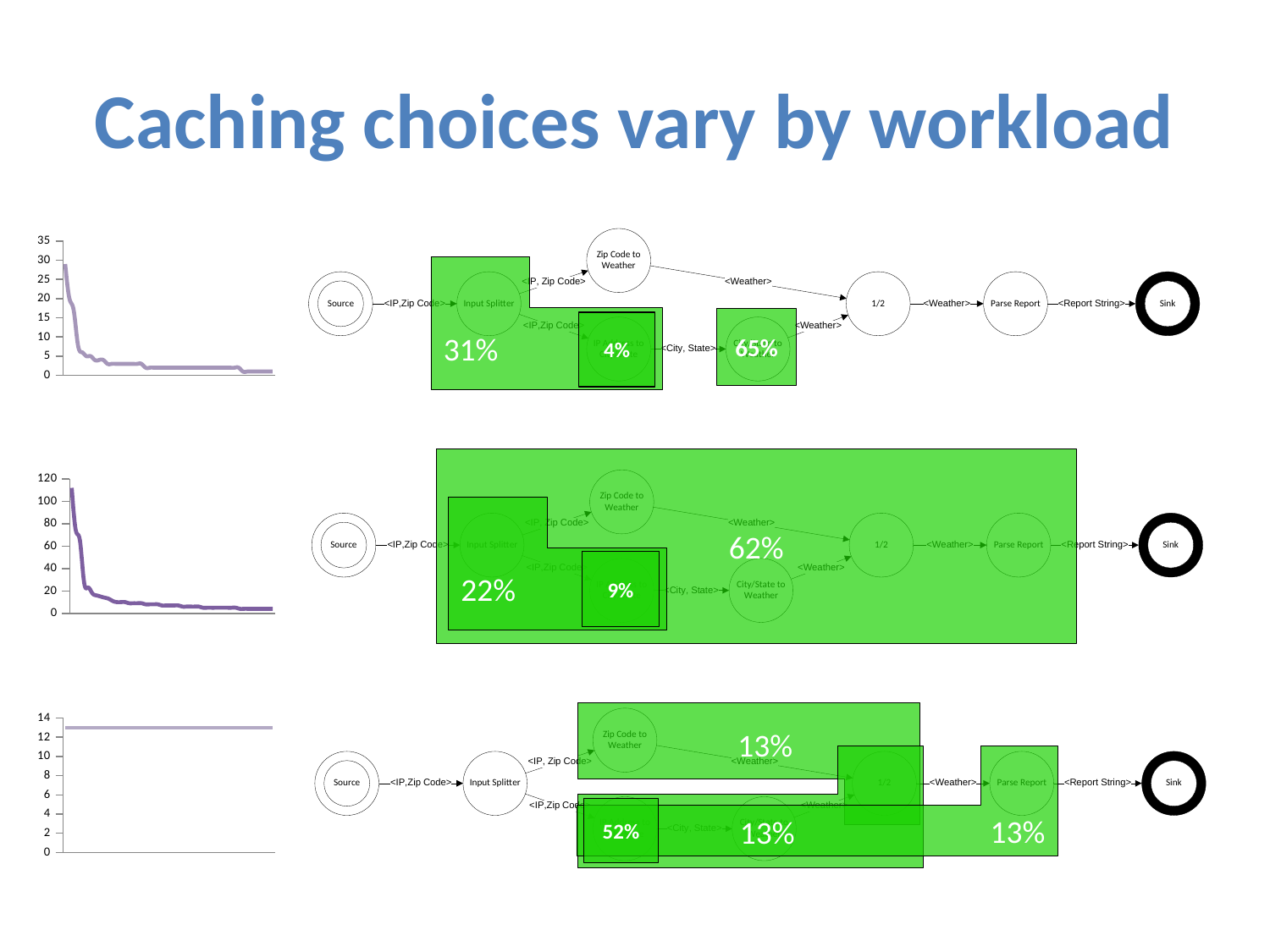
What kind of chart is the top-left chart on the slide? line chart In the bottom-left line chart, is the plotted value greater or less than 12? greater In the top-left line chart, do the values rise or fall along the x axis? fall In the middle-left line chart, is the first value greater or less than 100? greater In the middle-left line chart, is the last value greater or less than 20? less What kind of chart is the middle-left chart on the slide? line chart In the middle-left line chart, do the values rise or fall along the x axis? fall In the bottom-left line chart, do the values rise, fall, or stay flat along the x axis? stay flat What kind of chart is the bottom-left chart on the slide? line chart What is the highest y-axis tick shown on the top-left chart? 35